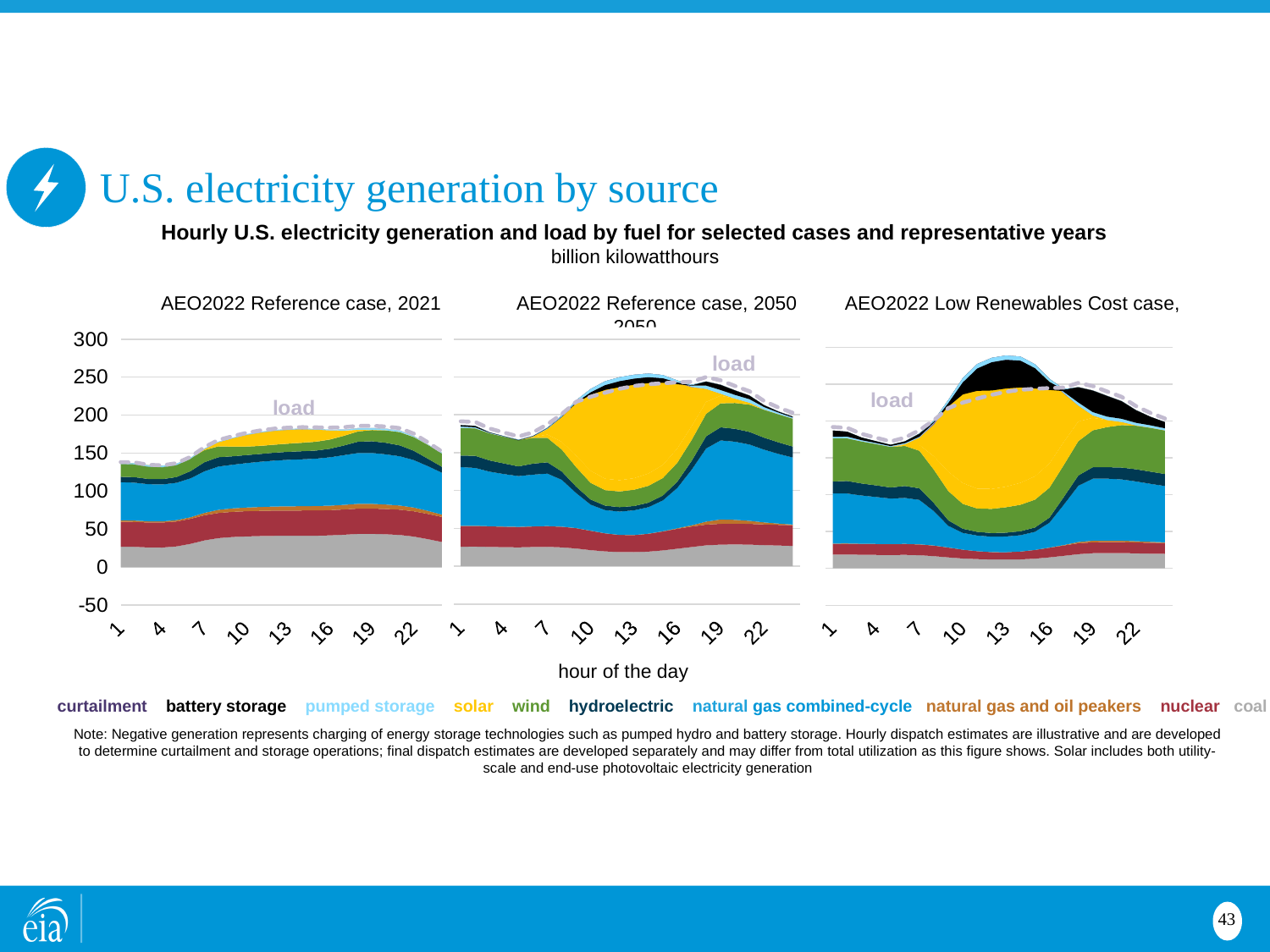
In the AEO2022 Reference case, 2021 chart, is the total generation at hour 1 greater or less than 100? greater In the AEO2022 Reference case, 2021 chart, is the peak load greater or less than 200? less What kind of chart is used on this slide? stacked area chart In the AEO2022 Reference case, 2050 chart, is the peak load greater or less than 200? greater How many charts are shown on the slide? 3 In the AEO2022 Reference case, 2021 chart, does load rise or fall from hour 1 to hour 13? rise How many fuel/source series does the legend list? 10 Which chart shows a larger coal contribution: AEO2022 Reference case, 2021 or AEO2022 Low Renewables Cost case? AEO2022 Reference case, 2021 What unit is the y axis measured in? billion kilowatthours What is the x-axis label shared by the three charts? hour of the day Which chart shows a larger solar contribution at midday: AEO2022 Reference case, 2021 or AEO2022 Reference case, 2050? AEO2022 Reference case, 2050